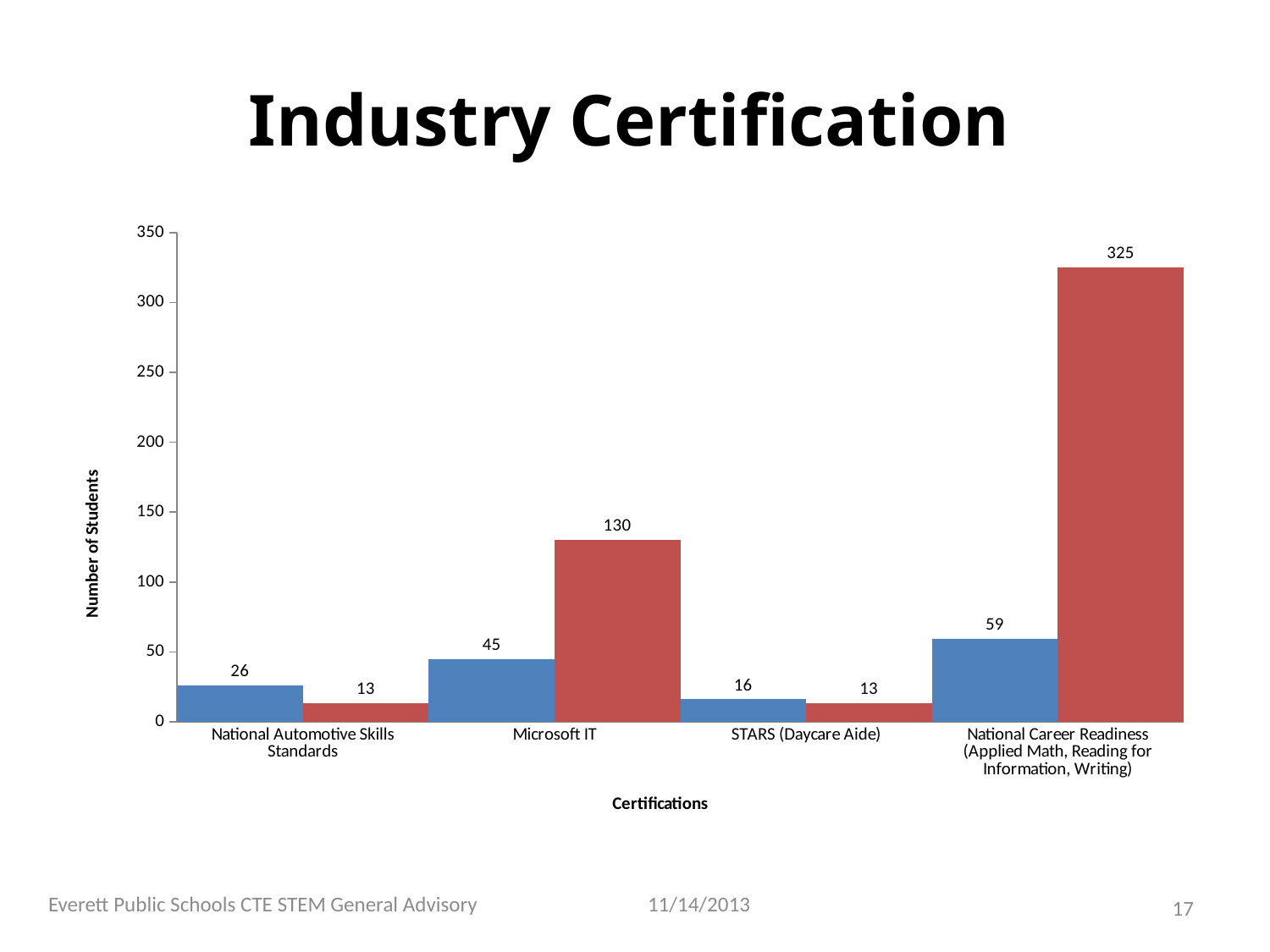
What is the value of the blue bar for STARS (Daycare Aide)? 16 How many certification categories are shown on the x axis? 4 Is the red bar for National Career Readiness (Applied Math, Reading for Information, Writing) greater or less than 300? greater What type of chart is shown on the slide? bar chart For National Automotive Skills Standards, which is larger, the blue bar or the red bar? the blue bar What is the value of the blue bar for National Career Readiness (Applied Math, Reading for Information, Writing)? 59 Which category has the highest red bar? National Career Readiness (Applied Math, Reading for Information, Writing) What is the title of the chart? Industry Certification What is the value of the red bar for Microsoft IT? 130 What is the label of the vertical axis? Number of Students Which category has the lowest blue bar? STARS (Daycare Aide) What is the difference between the red bar and the blue bar for Microsoft IT? 85